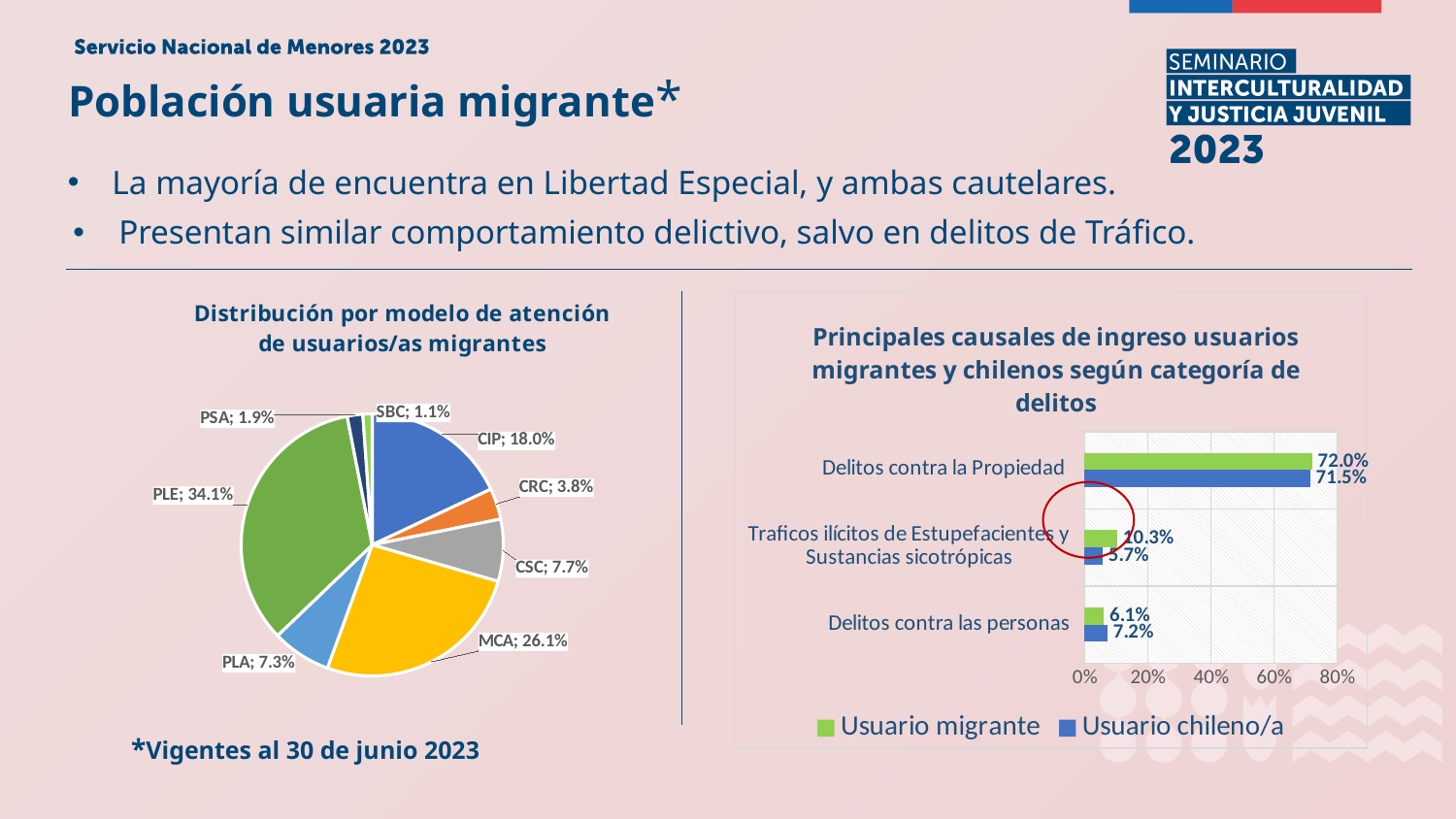
In the bar chart 'Principales causales de ingreso usuarios migrantes y chilenos según categoría de delitos', which series has the larger value for 'Traficos ilícitos de Estupefacientes y Sustancias sicotrópicas'? Usuario migrante In the pie chart 'Distribución por modelo de atención de usuarios/as migrantes', which category has the largest share? PLE What kind of chart is the one on the right, 'Principales causales de ingreso usuarios migrantes y chilenos según categoría de delitos'? Bar chart In the pie chart 'Distribución por modelo de atención de usuarios/as migrantes', what is the share for PLE? 34.1% In the bar chart 'Principales causales de ingreso usuarios migrantes y chilenos según categoría de delitos', what is the value for Usuario migrante in 'Delitos contra la Propiedad'? 72.0% In the pie chart 'Distribución por modelo de atención de usuarios/as migrantes', what is the difference between the CIP and CSC shares? 10.3% In the pie chart 'Distribución por modelo de atención de usuarios/as migrantes', how many slices are there? 8 In the pie chart 'Distribución por modelo de atención de usuarios/as migrantes', which is larger, PLA or CRC? PLA In the bar chart 'Principales causales de ingreso usuarios migrantes y chilenos según categoría de delitos', how many series does the legend list? 2 In the pie chart 'Distribución por modelo de atención de usuarios/as migrantes', which category has the smallest share? SBC In the pie chart 'Distribución por modelo de atención de usuarios/as migrantes', what is the share for MCA? 26.1% In the bar chart 'Principales causales de ingreso usuarios migrantes y chilenos según categoría de delitos', what is the value for Usuario chileno/a in 'Delitos contra las personas'? 7.2%